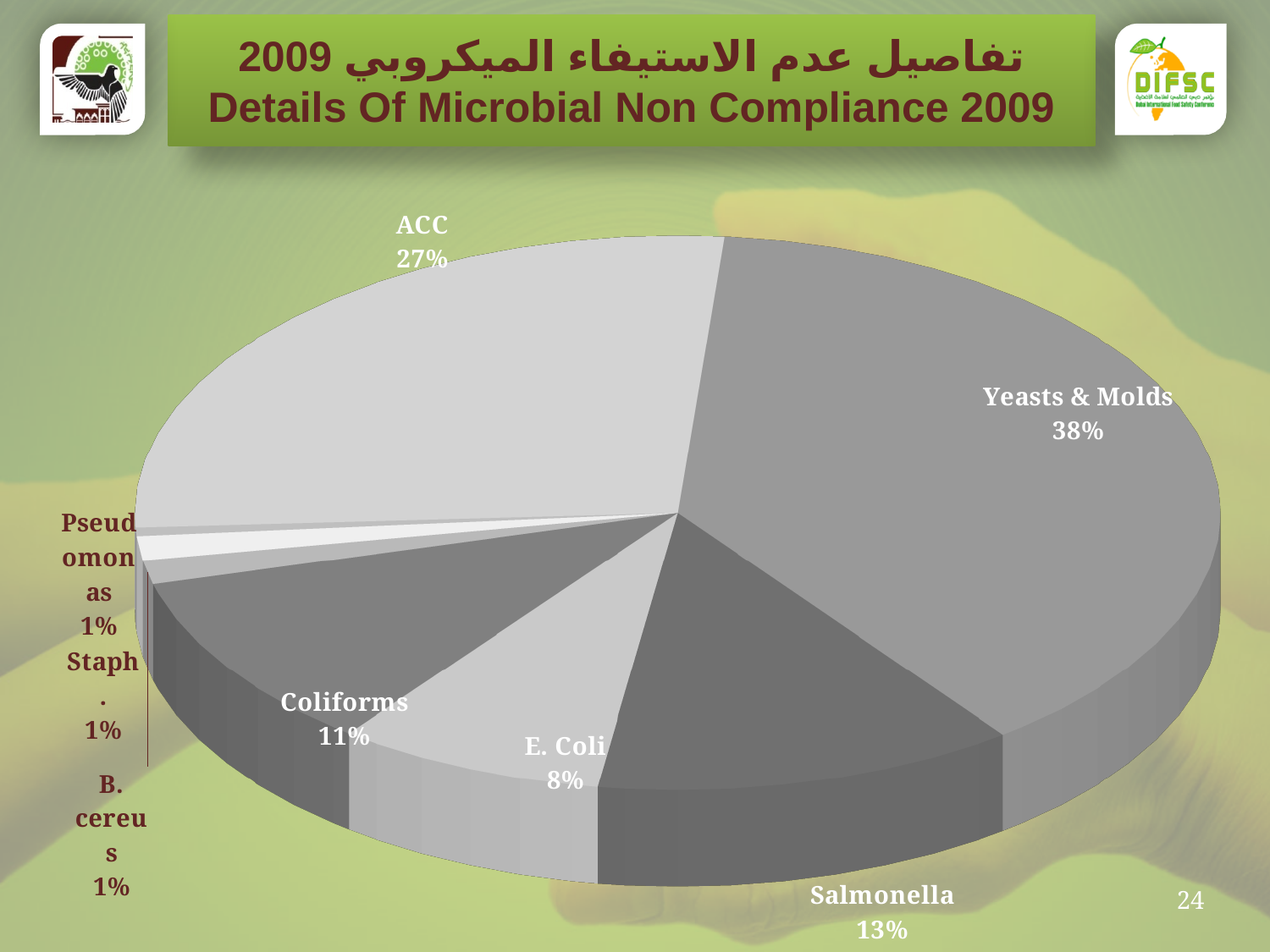
Which is larger, the share for Salmonella or the share for Coliforms? Salmonella What percentage is shown for Pseudomonas? 1% What kind of chart is shown on the slide? Pie chart What percentage is shown for Salmonella? 13% What share of the pie does Yeasts & Molds account for? 38% How many categories are shown in the pie chart? 8 What percentage is shown for Coliforms? 11% What is the difference in percentage points between Yeasts & Molds and ACC? 11 What percentage is shown for ACC? 27% Which category has the largest slice of the pie? Yeasts & Molds What is the English title of the chart on the slide? Details Of Microbial Non Compliance 2009 What percentage is shown for E. Coli? 8%